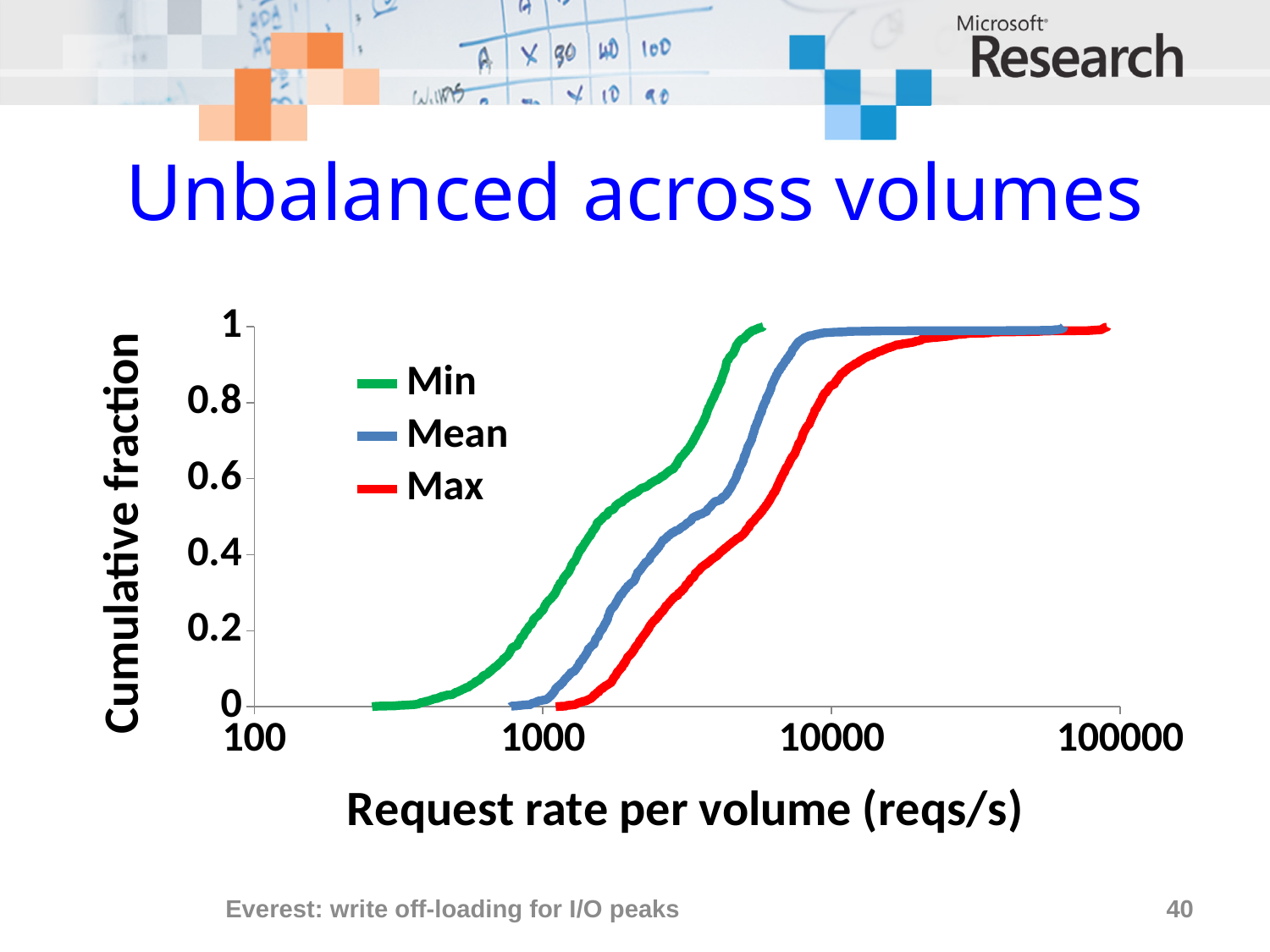
What is the label of the x axis? Request rate per volume (reqs/s) Which series reaches a cumulative fraction of 1 at the lowest request rate? Min At a request rate of 1000 reqs/s, is the cumulative fraction for the Mean series greater or less than 0.2? less Which series reaches a cumulative fraction of 1 at the highest request rate? Max What kind of chart is shown on the slide? line chart Do the curves rise or fall as the request rate increases along the x axis? rise What are the three series named in the legend? Min, Mean, Max At a request rate of 1000 reqs/s, which series has the higher cumulative fraction, Min or Max? Min At a request rate of 1000 reqs/s, is the cumulative fraction for the Min series greater or less than 0.2? greater How many series does the legend list? 3 At a request rate of 10000 reqs/s, is the cumulative fraction for the Mean series greater or less than 0.8? greater